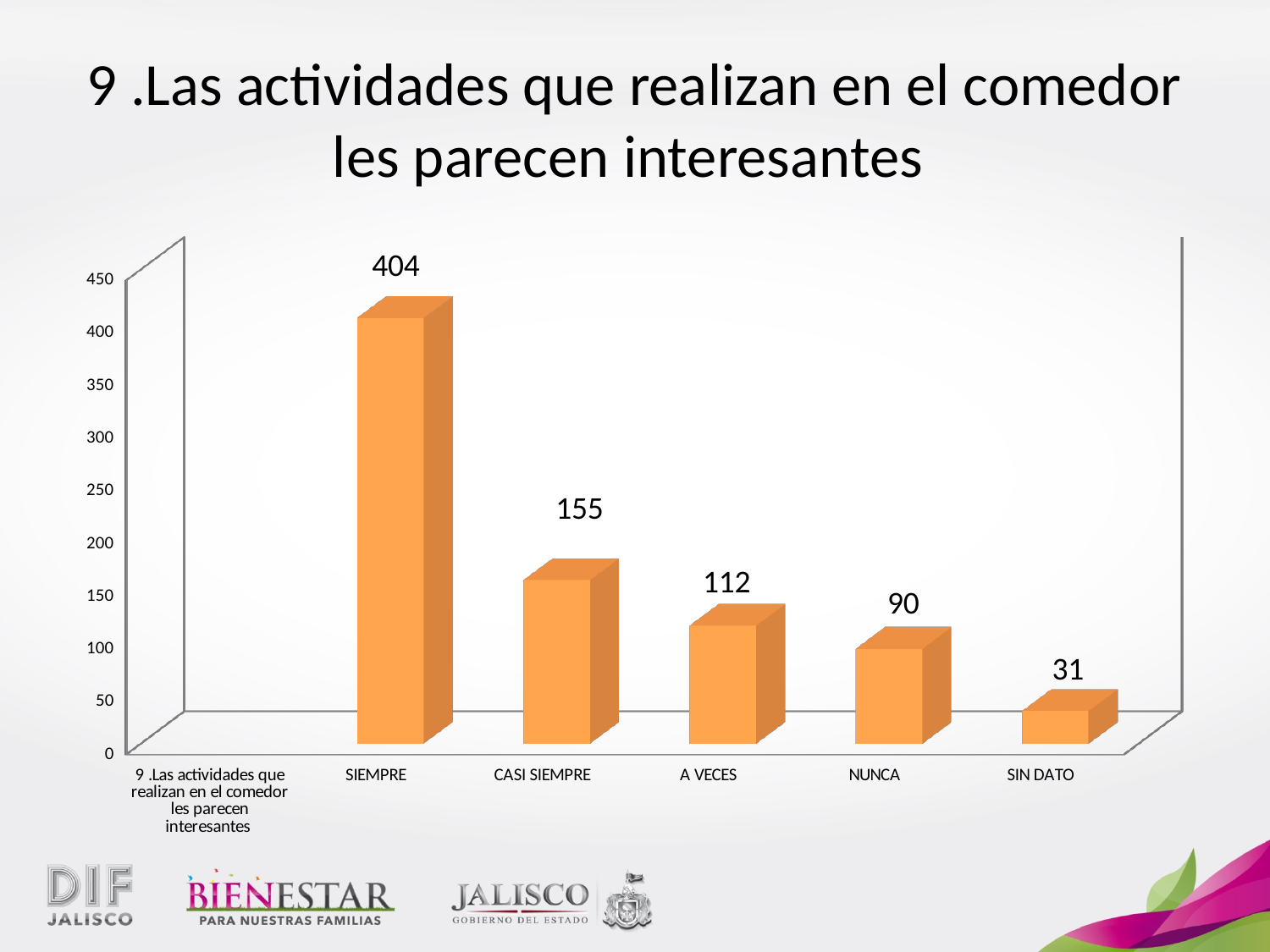
What is the value for A VECES? 112 Do the values rise or fall from SIEMPRE to SIN DATO along the x axis? Fall Which is larger, the value for A VECES or the value for NUNCA? A VECES What is the value for SIEMPRE? 404 What kind of chart is shown on the slide? Bar chart How many categories with bars are shown in the chart? 5 What is the difference between the values for SIEMPRE and CASI SIEMPRE? 249 Which category has the lowest value? SIN DATO What is the value for NUNCA? 90 What is the value for CASI SIEMPRE? 155 Which category has the highest value? SIEMPRE What is the value for SIN DATO? 31